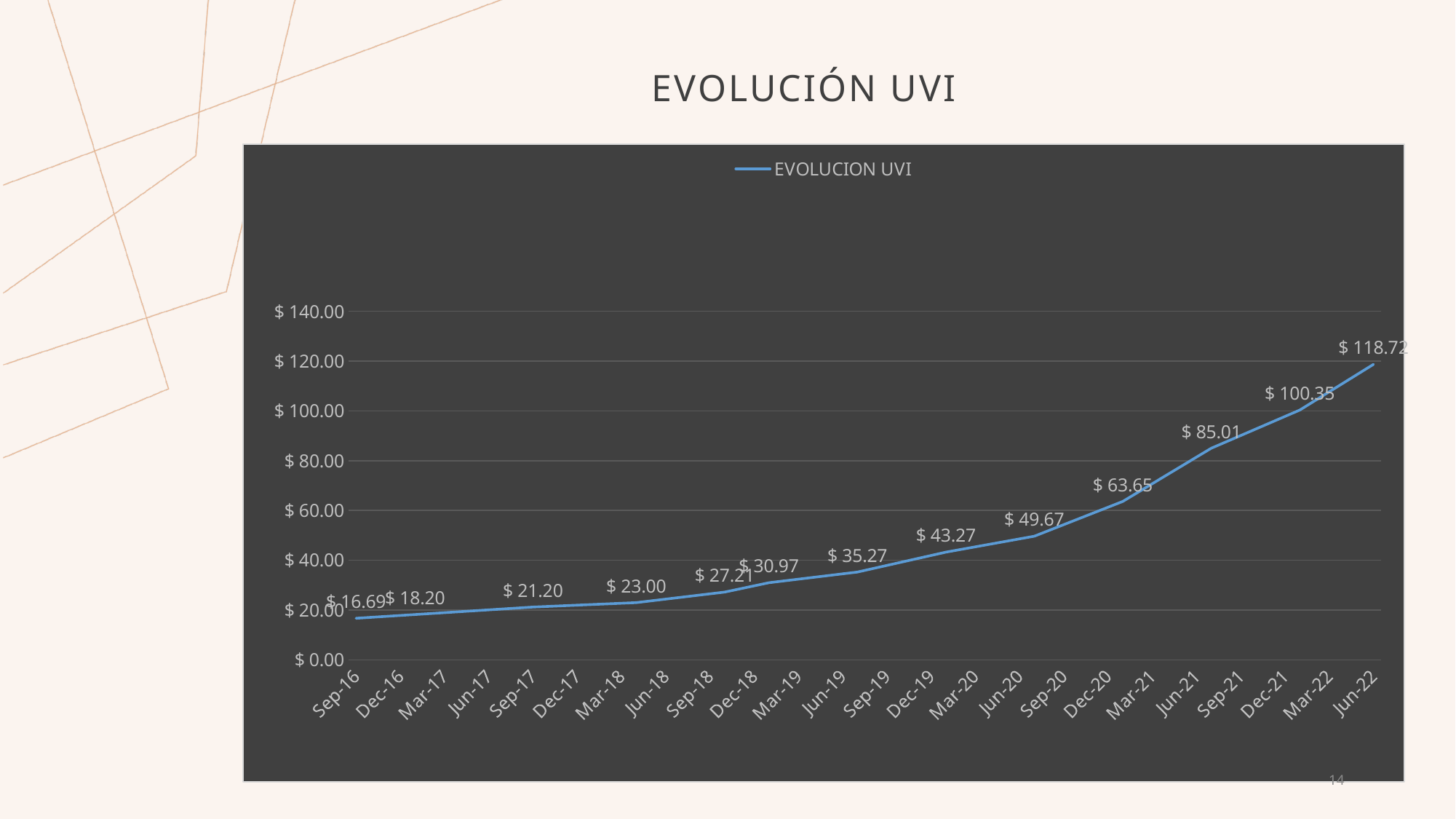
Which date has the lowest value? Sep-16 Do the values rise or fall from Sep-16 to Jun-22? Rise What is the value for Sep-16? $ 16.69 Which date has the highest value? Jun-22 Is the value for Mar-22 greater or less than 100? greater What is the value for Jun-22? $ 118.72 What is the difference between the values for Jun-22 and Sep-16? $ 102.03 What type of chart is shown on the slide? Line chart How many data points are plotted on the x axis? 13